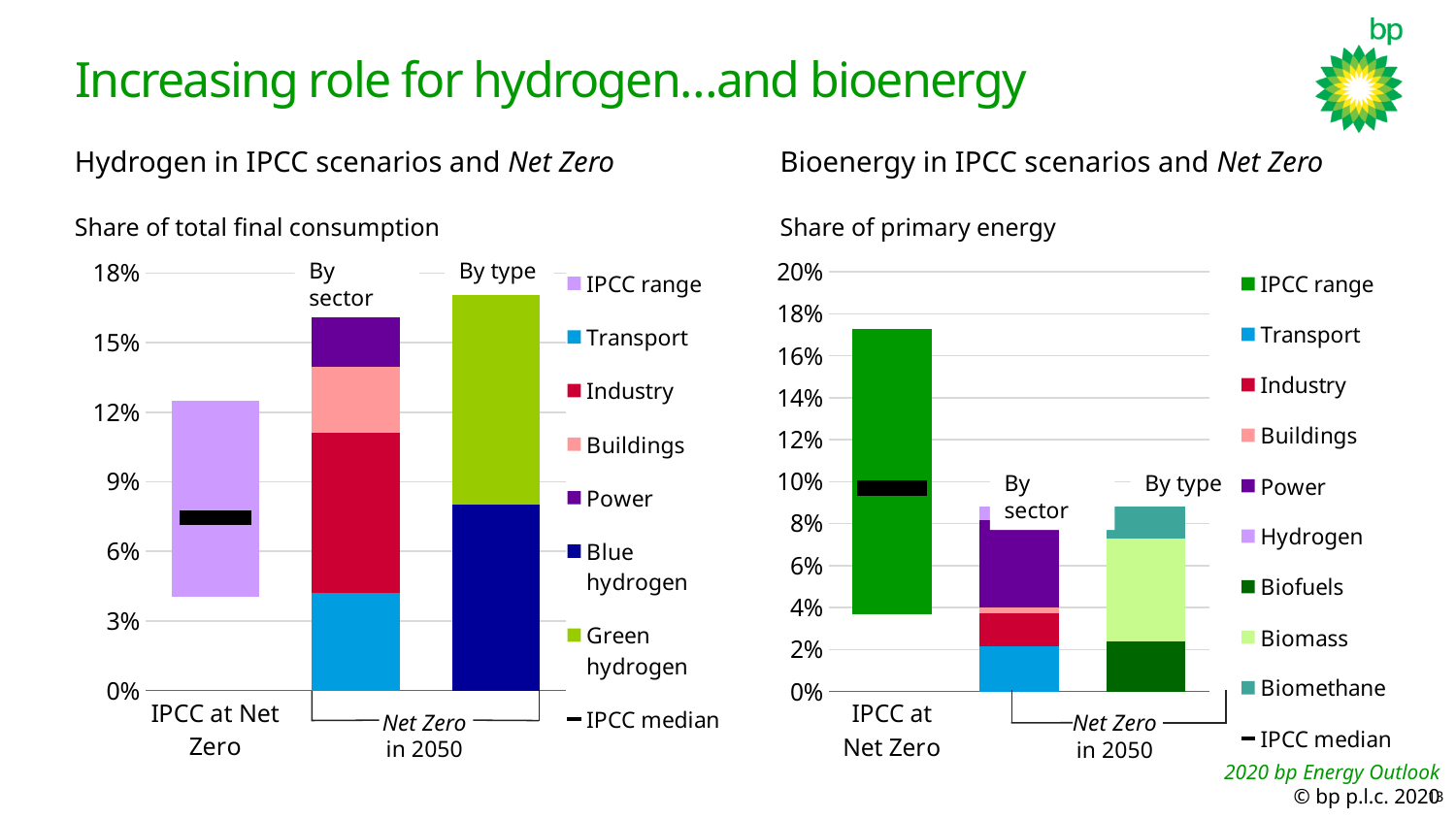
How many entries does the legend of the right chart, 'Bioenergy in IPCC scenarios and Net Zero', list? 10 In the left chart, 'Hydrogen in IPCC scenarios and Net Zero', is the top of the 'By type' stacked bar greater or less than 15%? greater How many bars are plotted in the left chart, 'Hydrogen in IPCC scenarios and Net Zero'? 3 In the left chart, 'Hydrogen in IPCC scenarios and Net Zero', is the IPCC median greater or less than 9%? less How many entries does the legend of the left chart, 'Hydrogen in IPCC scenarios and Net Zero', list? 8 In the right chart, 'Bioenergy in IPCC scenarios and Net Zero', is the top of the IPCC range bar greater or less than 16%? greater What kind of chart is the left chart, 'Hydrogen in IPCC scenarios and Net Zero'? bar chart In the right chart, 'Bioenergy in IPCC scenarios and Net Zero', which segment of the 'By type' bar is larger: Biomass or Biomethane? Biomass What is the y-axis label of the right chart, 'Bioenergy in IPCC scenarios and Net Zero'? Share of primary energy In the right chart, 'Bioenergy in IPCC scenarios and Net Zero', which reaches higher: the top of the IPCC range bar or the top of the 'By sector' bar? IPCC range